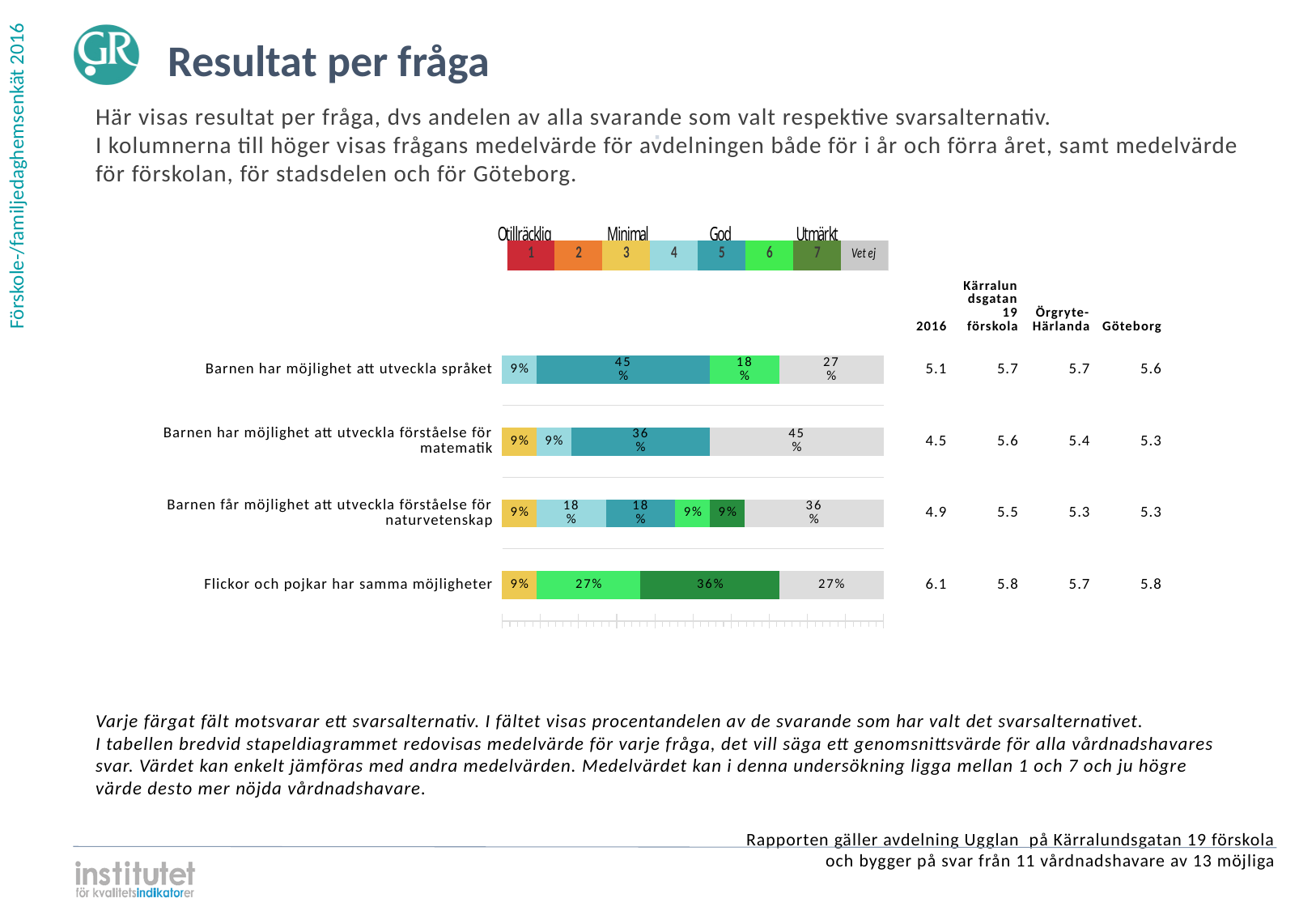
What kind of chart is used to show the results per question? Stacked bar chart What is the 2016 mean value for 'Flickor och pojkar har samma möjligheter'? 6.1 What is the Göteborg mean value for 'Barnen har möjlighet att utveckla förståelse för matematik'? 5.3 How many answer alternatives does the legend above the chart list (including 'Vet ej')? 8 What percentage of respondents chose answer 5 (teal) for 'Barnen har möjlighet att utveckla språket'? 45% What percentage chose 'Vet ej' for 'Barnen har möjlighet att utveckla förståelse för matematik'? 45% What percentage chose answer 7 (dark green) for 'Flickor och pojkar har samma möjligheter'? 36% What is the difference in percentage points between the 'Vet ej' share for the matematik question (45%) and the språket question (27%)? 18 percentage points How many questions (categories) are shown as bars in the chart? 4 Which has the higher 2016 mean: 'Flickor och pojkar har samma möjligheter' or 'Barnen har möjlighet att utveckla språket'? Flickor och pojkar har samma möjligheter Which question has the lowest 2016 mean value? Barnen har möjlighet att utveckla förståelse för matematik Which question has the largest 'Vet ej' share? Barnen har möjlighet att utveckla förståelse för matematik